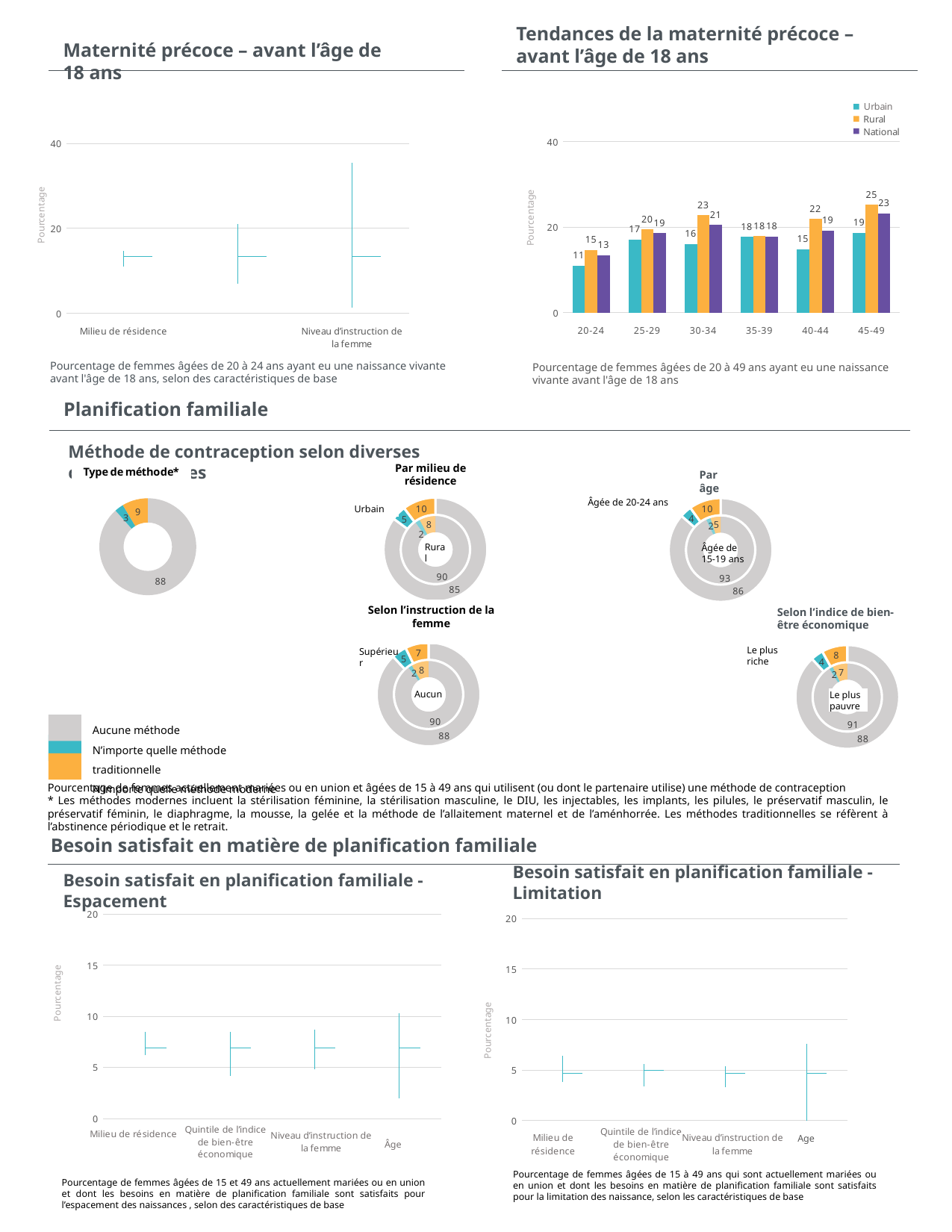
In the chart 'Tendances de la maternité précoce – avant l'âge de 18 ans', what is the Rural value for the 45-49 age group? 25 In the chart 'Tendances de la maternité précoce – avant l'âge de 18 ans', which age group has the highest Rural value? 45-49 In the chart 'Tendances de la maternité précoce – avant l'âge de 18 ans', is the Rural value for 30-34 larger or smaller than the National value for 30-34? larger In the chart 'Tendances de la maternité précoce – avant l'âge de 18 ans', what is the difference between the Rural and Urbain values for the 40-44 age group? 7 In the chart 'Tendances de la maternité précoce – avant l'âge de 18 ans', which age group has the lowest Urbain value? 20-24 In the chart 'Tendances de la maternité précoce – avant l'âge de 18 ans', what is the Urbain value for the 20-24 age group? 11 In the 'Par âge' donut chart, what is the value for 'Aucune méthode' among women aged 15-19? 93 In the chart 'Tendances de la maternité précoce – avant l'âge de 18 ans', what is the National value for the 30-34 age group? 21 What type of chart is 'Tendances de la maternité précoce – avant l'âge de 18 ans'? bar chart In the 'Type de méthode*' donut chart, what percentage of women use no method (Aucune méthode)? 88 How many series does the legend of the chart 'Tendances de la maternité précoce – avant l'âge de 18 ans' list? 3 How many age groups are shown on the x axis of the chart 'Tendances de la maternité précoce – avant l'âge de 18 ans'? 6